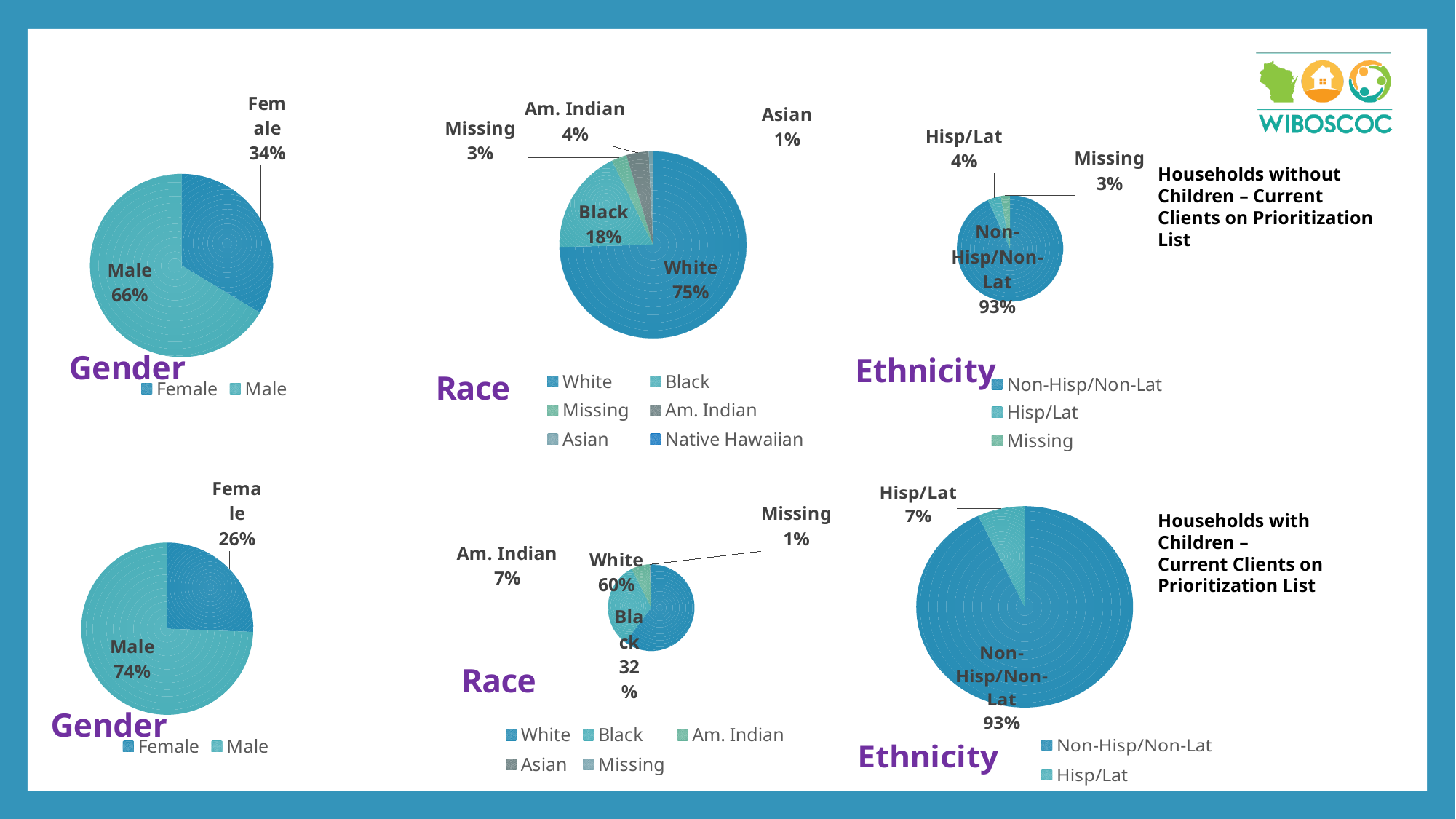
How many entries does the legend of the top Race pie chart (Households without Children) list? 6 In the top-left Gender pie chart (Households without Children), what share is Female? 34% In the bottom Race pie chart (Households with Children), what share is Black? 32% In the bottom Race pie chart (Households with Children), which category has the smallest labelled share? Missing In the top Race pie chart (Households without Children), which category has the largest share? White In the top Race pie chart (Households without Children), what share is White? 75% What type of chart is used for the bottom-right Ethnicity chart (Households with Children)? Pie chart In the top Race pie chart (Households without Children), what is the difference between the White and Black shares? 57% In the bottom-left Gender pie chart (Households with Children), which is larger, Male or Female? Male In the top-left Gender pie chart (Households without Children), what share is Male? 66% In the bottom-left Gender pie chart (Households with Children), what share is Female? 26% In the top-right Ethnicity pie chart (Households without Children), what share is Hisp/Lat? 4%